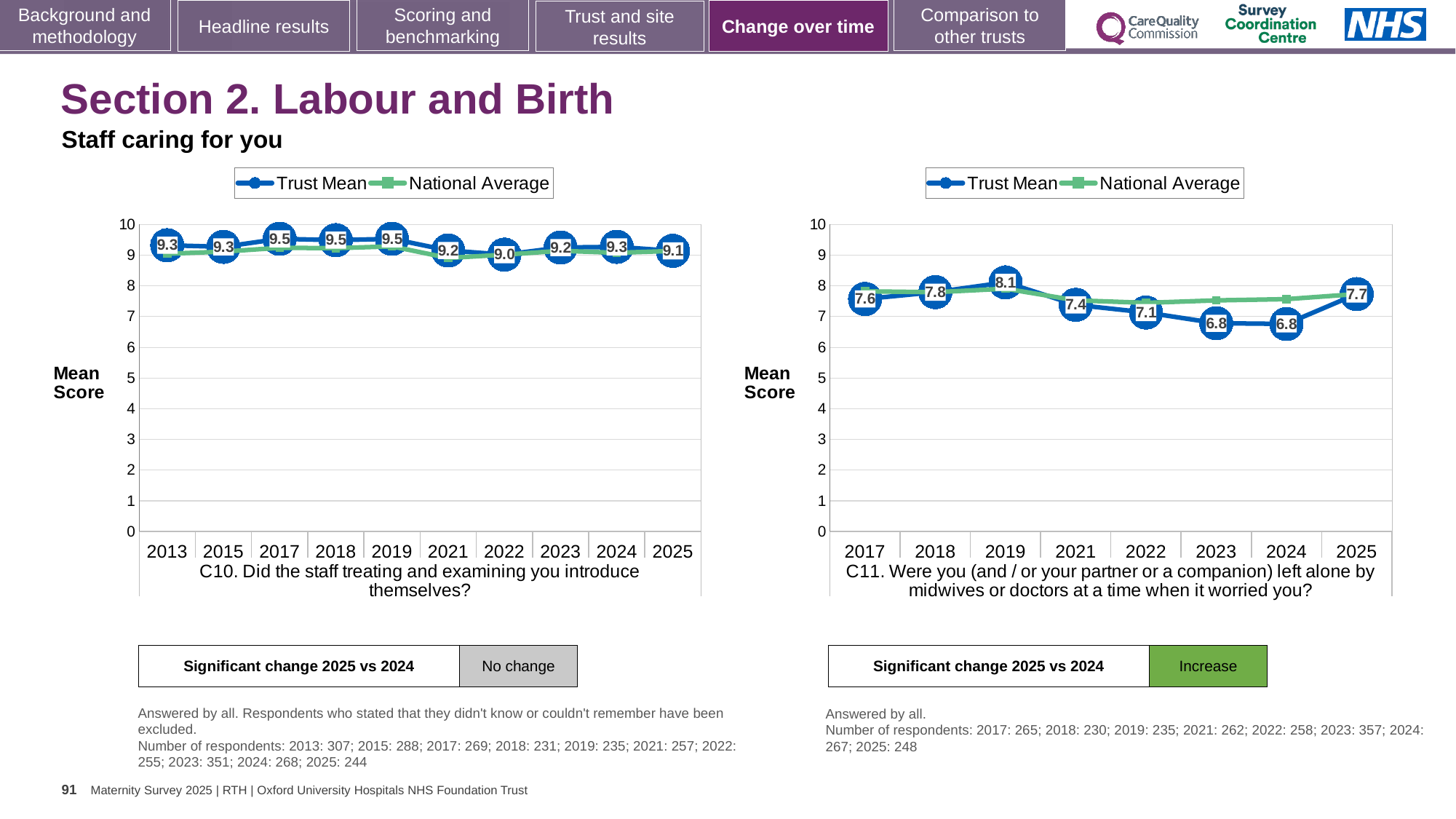
What does the 'Significant change 2025 vs 2024' box below the C11 chart say? Increase In the C10 chart, which year has the lowest Trust Mean score? 2022 In the C11 chart, does the Trust Mean rise or fall from 2019 to 2023? Fall In the C11 chart, what is the difference between the Trust Mean scores for 2025 and 2024? 0.9 In the C11 chart, is the National Average value for 2023 greater or less than 7? greater In the C10 chart, what is the Trust Mean score for 2022? 9.0 In the C11 chart, which year has the highest Trust Mean score? 2019 In the C11 chart, what is the Trust Mean score for 2019? 8.1 In the C10 chart, is the Trust Mean score higher in 2017 or in 2025? 2017 How many series does the legend of the C10 chart list? 2 How many years are plotted on the x axis of the C11 chart? 8 What type of chart is the C10 chart? Line chart